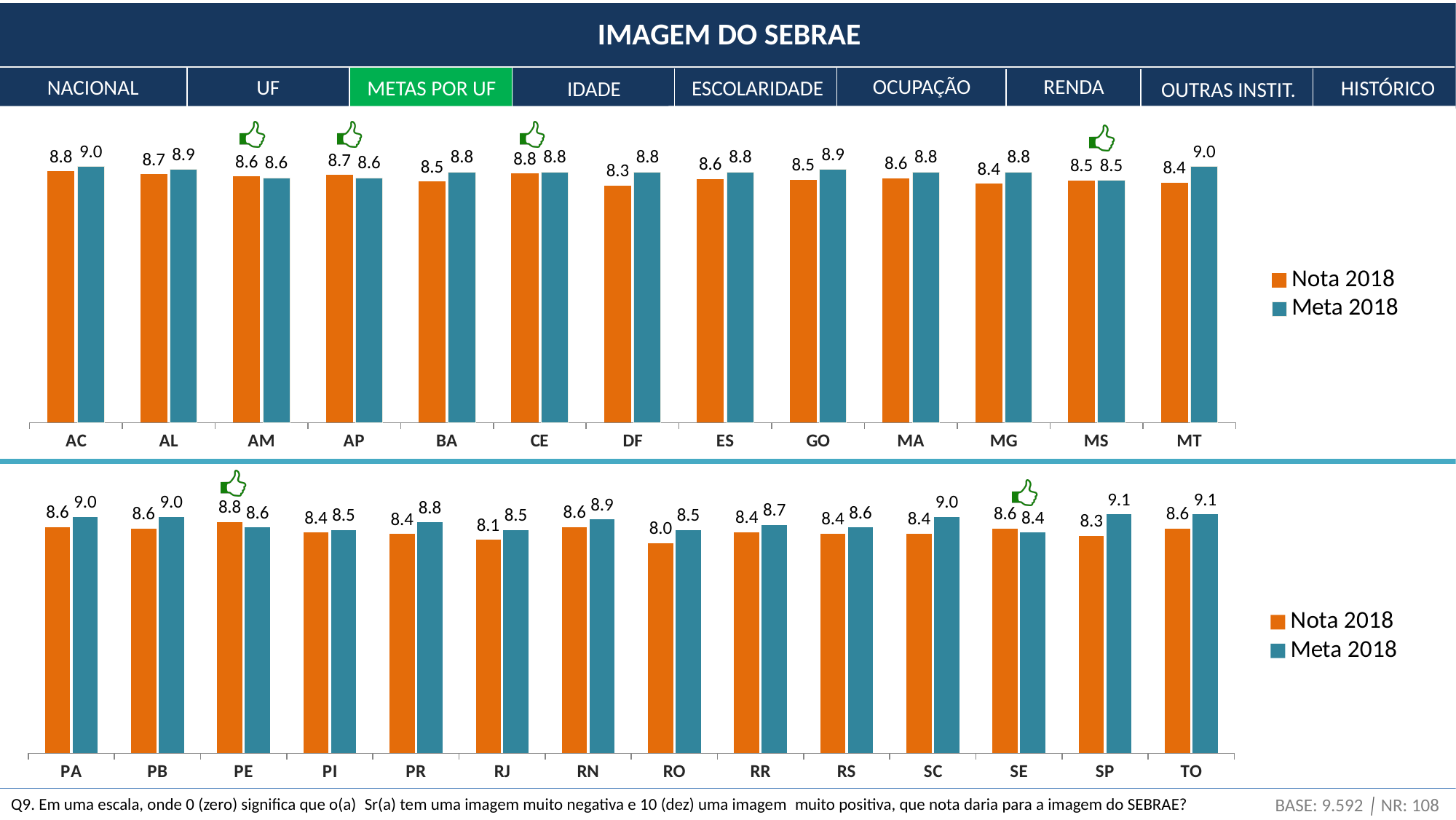
How many states are shown in the top chart (AC to MT)? 13 In the bottom chart (PA to TO), which state has the highest Nota 2018 value? PE How many series does the legend of the bottom chart (PA to TO) list? 2 In the bottom chart (PA to TO), what is the Meta 2018 value for SP? 9.1 In the bottom chart (PA to TO), what is the Nota 2018 value for RO? 8.0 In the top chart (AC to MT), what is the difference between the Meta 2018 and Nota 2018 values for MT? 0.6 In the bottom chart (PA to TO), which is larger for SE: Nota 2018 or Meta 2018? Nota 2018 In the top chart (AC to MT), what is the Meta 2018 value for MT? 9.0 In the top chart (AC to MT), what is the Nota 2018 value for DF? 8.3 In the top chart (AC to MT), which state has the lowest Nota 2018 value? DF What type of chart is the top chart (AC to MT)? Bar chart In the bottom chart (PA to TO), which state has the lowest Nota 2018 value? RO